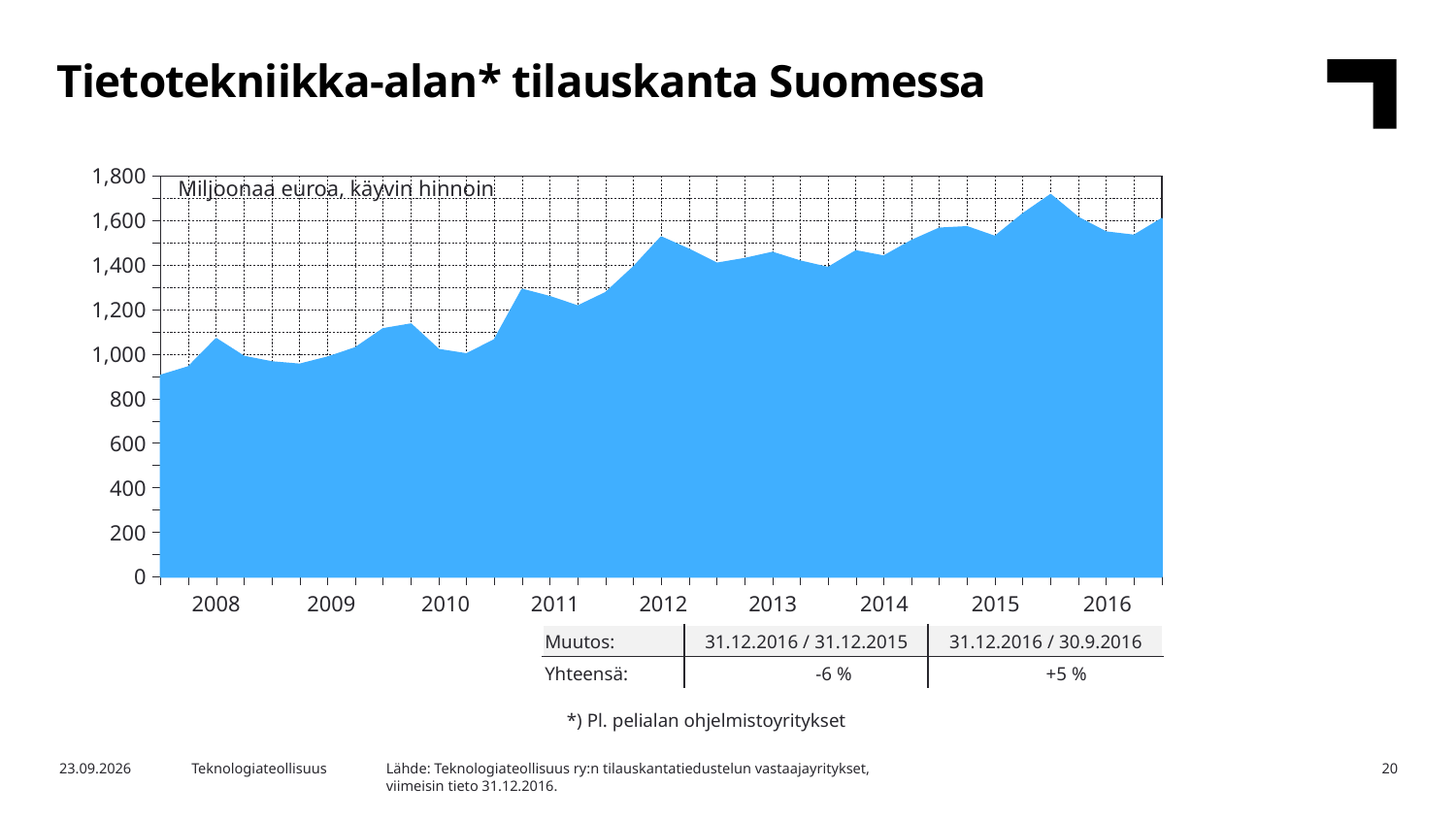
What kind of chart is shown on the slide? Area chart What is the title of the chart on the slide? Tietotekniikka-alan* tilauskanta Suomessa What is the highest value shown on the y axis of the chart? 1,800 Is the value at the start of 2008 greater or less than 1,000? less Overall, do the values rise or fall from 2008 to 2016? rise Is the highest point of the chart, reached in 2015, greater or less than 1,600? greater In which year does the chart reach its highest value? 2015 Is the value at the end of 2016 greater or less than 1,400? greater In which year does the chart show its lowest value? 2008 What unit is stated inside the chart area? Miljoonaa euroa, käyvin hinnoin How many years are labelled on the x axis of the chart? 9